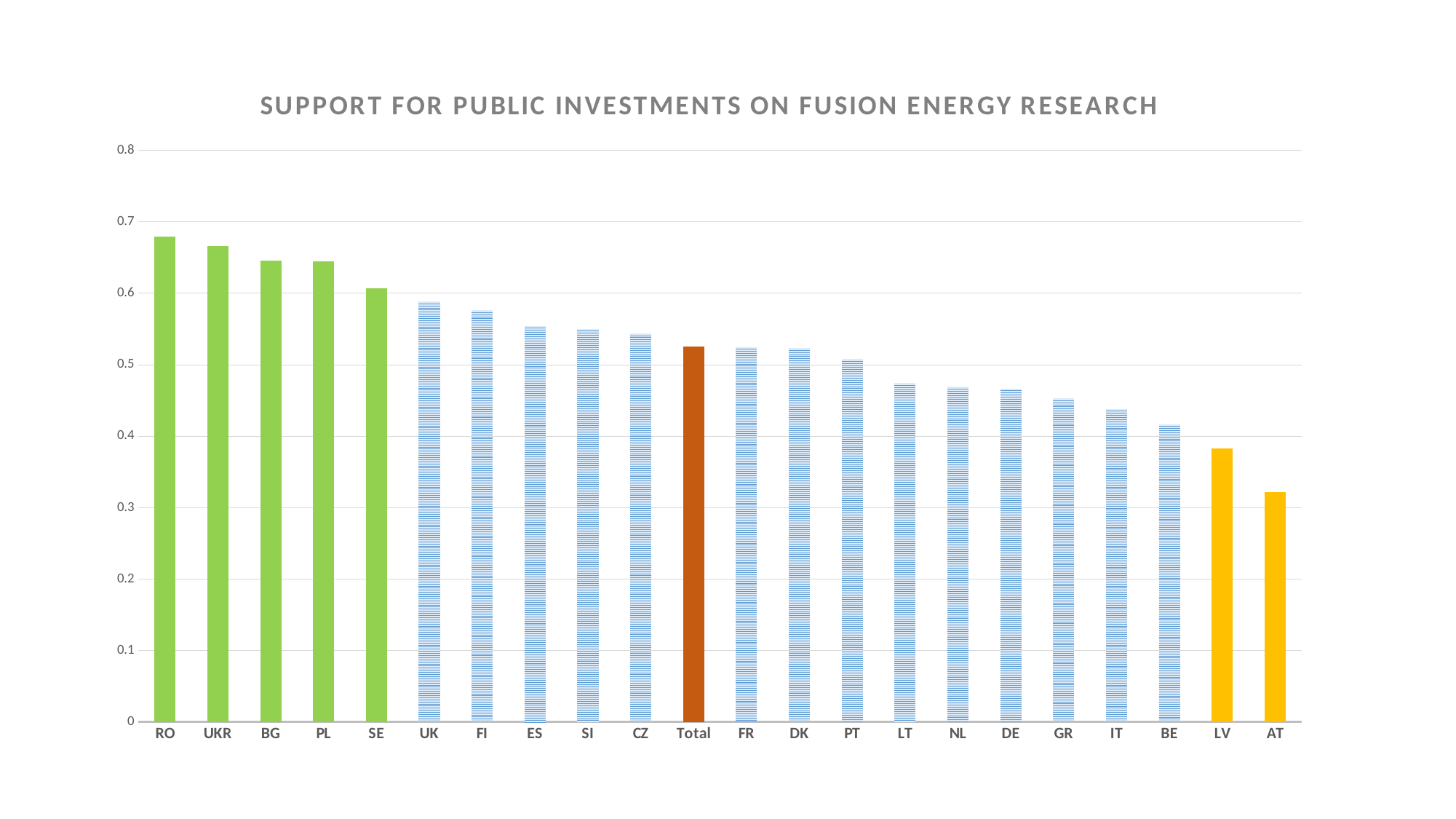
Which has a larger value, UK or LV? UK Do the values generally rise or fall moving from left to right along the x axis? Fall Is the value for RO greater or less than 0.6? greater Is the value for AT greater or less than 0.4? less Is the value for Total greater or less than 0.5? greater What colour is the bar for Total? Orange Which category has the highest value in the chart? RO How many bars (categories) are plotted in the chart? 22 What is the title of the chart? SUPPORT FOR PUBLIC INVESTMENTS ON FUSION ENERGY RESEARCH Which category has the lowest value in the chart? AT What kind of chart is shown on the slide? Bar chart